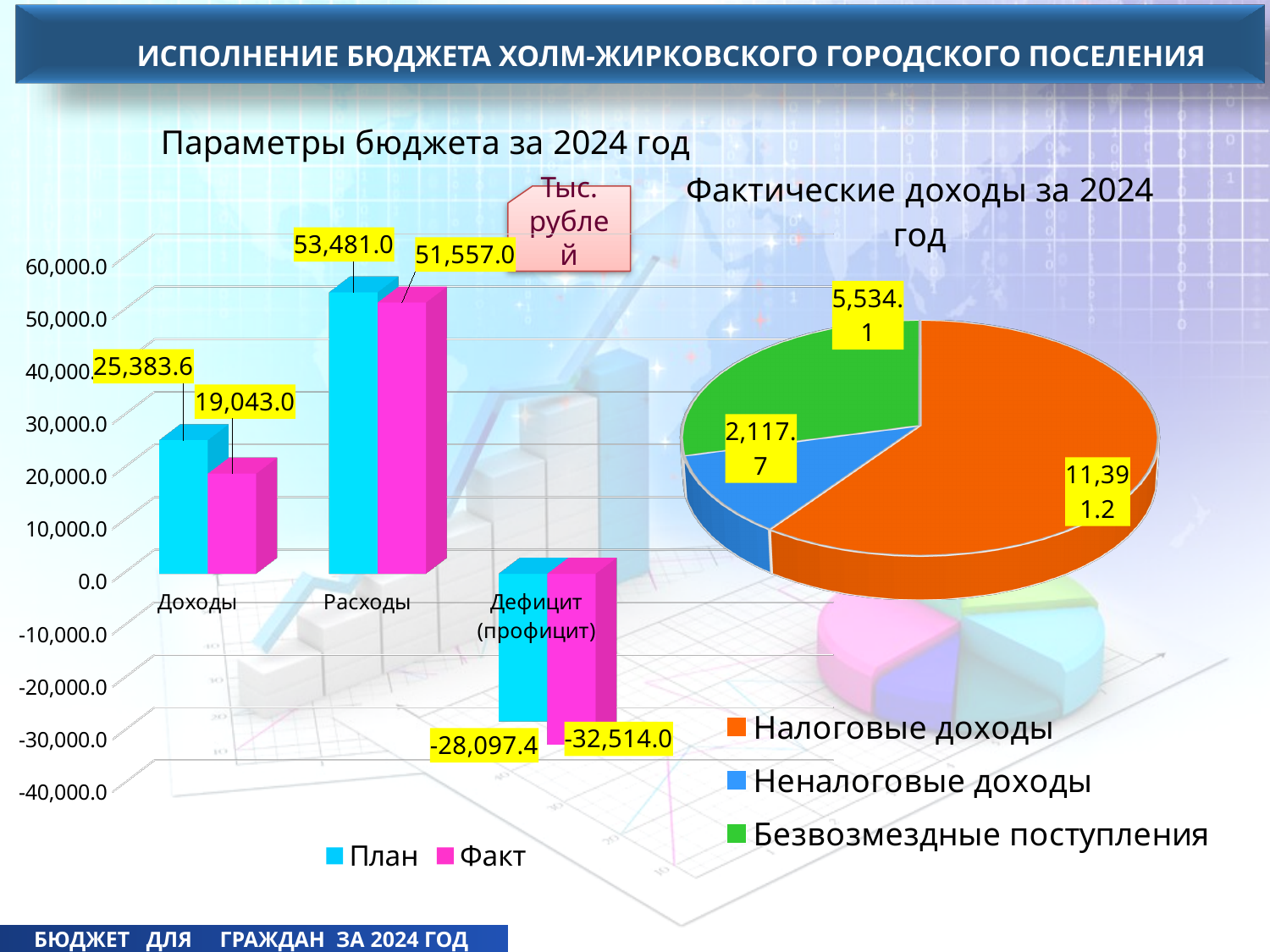
How many series does the legend of the bar chart 'Параметры бюджета за 2024 год' list? 2 In the bar chart 'Параметры бюджета за 2024 год', which is larger for Доходы: План or Факт? План In the bar chart 'Параметры бюджета за 2024 год', what is the Факт value for Расходы? 51,557.0 In the bar chart 'Параметры бюджета за 2024 год', what is the difference between the План and Факт values for Расходы? 1,924.0 In the bar chart 'Параметры бюджета за 2024 год', which category has the highest План value? Расходы In the bar chart 'Параметры бюджета за 2024 год', what is the План value for Доходы? 25,383.6 In the pie chart 'Фактические доходы за 2024 год', what colour is the slice for Безвозмездные поступления? Green How many categories does the pie chart 'Фактические доходы за 2024 год' show? 3 In the pie chart 'Фактические доходы за 2024 год', what is the value for Неналоговые доходы? 2,117.7 What kind of chart is 'Параметры бюджета за 2024 год'? Bar chart In the pie chart 'Фактические доходы за 2024 год', which category has the largest value? Налоговые доходы In the bar chart 'Параметры бюджета за 2024 год', what is the Факт value for Дефицит (профицит)? -32,514.0